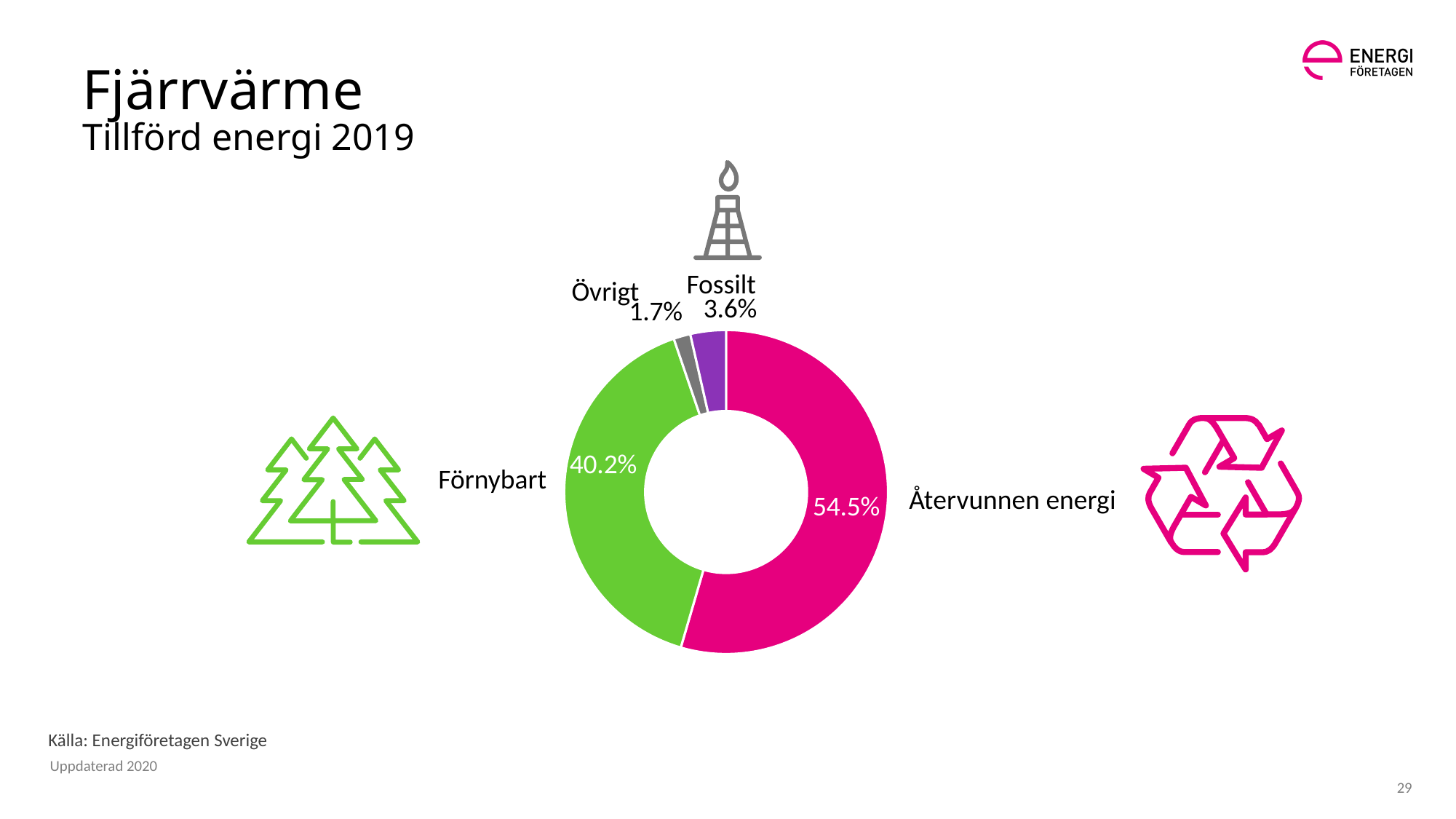
What share of the supplied energy comes from Återvunnen energi? 54.5% Which category has the largest share of the chart? Återvunnen energi What share of the supplied energy comes from Övrigt? 1.7% Which is larger, the share for Fossilt or the share for Övrigt? Fossilt What kind of chart is shown on the slide? Doughnut chart What is the difference in percentage points between Återvunnen energi and Förnybart? 14.3 What share of the supplied energy comes from Förnybart? 40.2% What share of the supplied energy comes from Fossilt? 3.6% What is the difference in percentage points between Fossilt and Övrigt? 1.9 Which category has the smallest share of the chart? Övrigt What colour is the Förnybart segment of the chart? Green How many categories are shown in the chart? 4